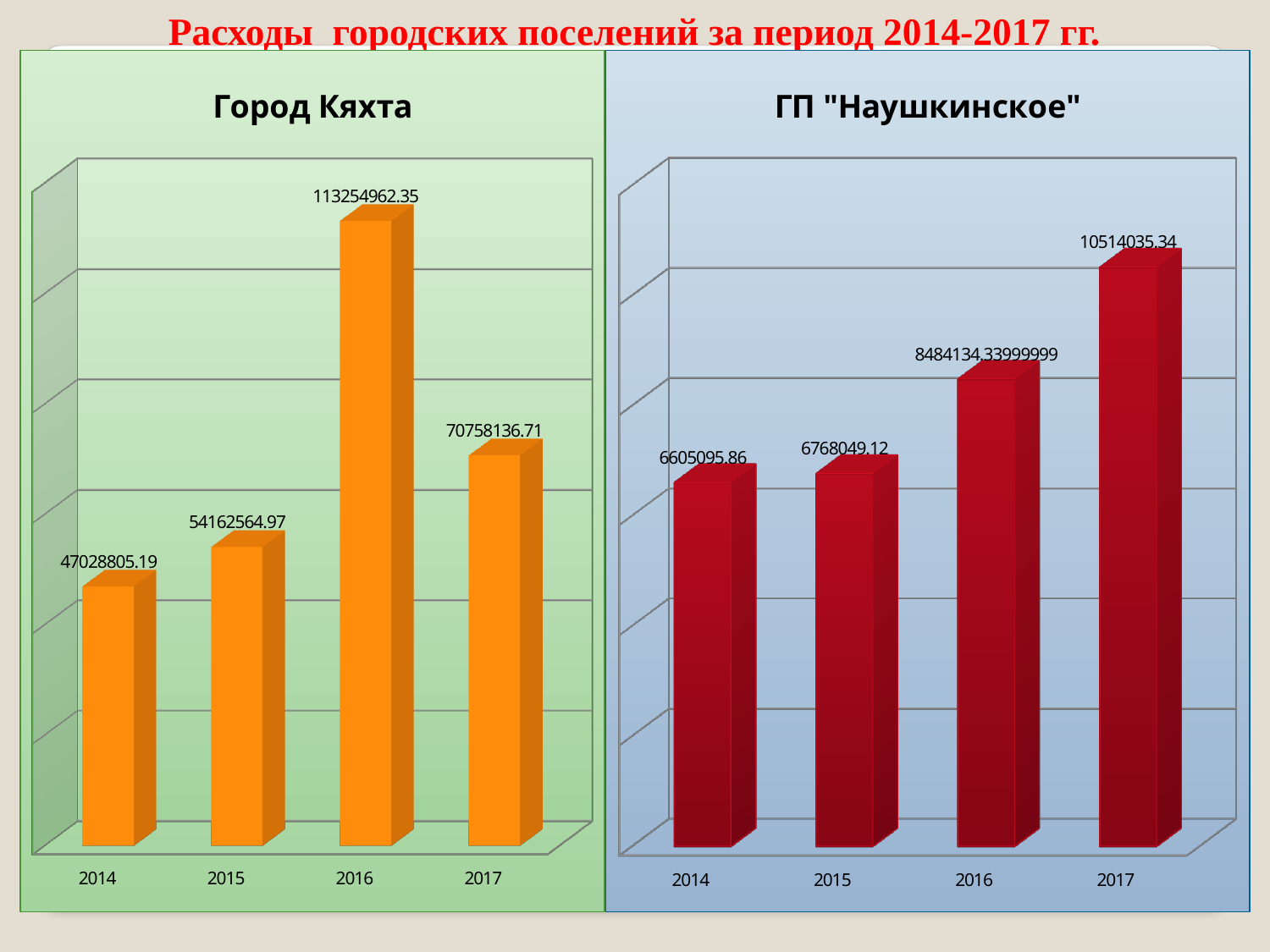
In the "ГП "Наушкинское"" chart, which year has the highest value? 2017 In the "Город Кяхта" chart, what is the value for 2016? 113254962.35 In the "Город Кяхта" chart, which year has the lowest value? 2014 In the "ГП "Наушкинское"" chart, what is the difference between the values for 2017 and 2014? 3908939.48 In the "Город Кяхта" chart, what is the difference between the values for 2016 and 2017? 42496825.64 In the "Город Кяхта" chart, which year has the highest value? 2016 In the "Город Кяхта" chart, which is larger, the value for 2015 or the value for 2017? 2017 In the "ГП "Наушкинское"" chart, do the values rise or fall from 2014 to 2017? rise How many years are shown in the "Город Кяхта" chart? 4 In the "ГП "Наушкинское"" chart, what is the value for 2015? 6768049.12 In the "Город Кяхта" chart, what is the value for 2014? 47028805.19 In the "ГП "Наушкинское"" chart, what is the value for 2017? 10514035.34